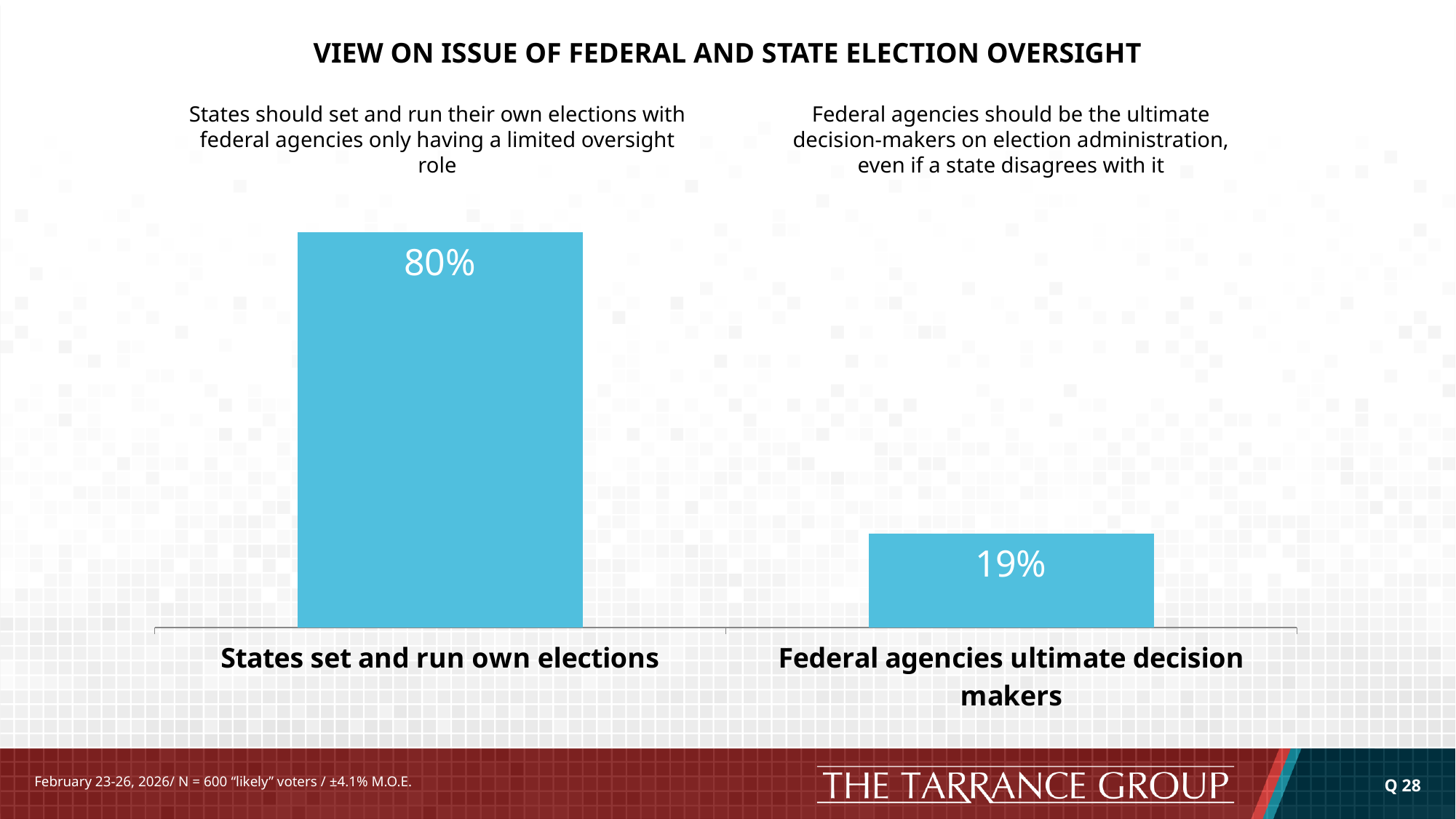
What is the title of the chart? VIEW ON ISSUE OF FEDERAL AND STATE ELECTION OVERSIGHT Which category has the lowest value? Federal agencies ultimate decision makers What percentage of respondents say states should set and run their own elections? 80% What percentage of respondents say federal agencies should be the ultimate decision makers? 19% Which is larger: the value for 'States set and run own elections' or the value for 'Federal agencies ultimate decision makers'? States set and run own elections How many categories are shown in the chart? 2 What colour are the bars in the chart? Light blue What kind of chart is shown on the slide? Bar chart What is the difference between the value for 'States set and run own elections' and the value for 'Federal agencies ultimate decision makers'? 61% What is the total of the two values shown in the chart? 99% Which category has the highest value? States set and run own elections